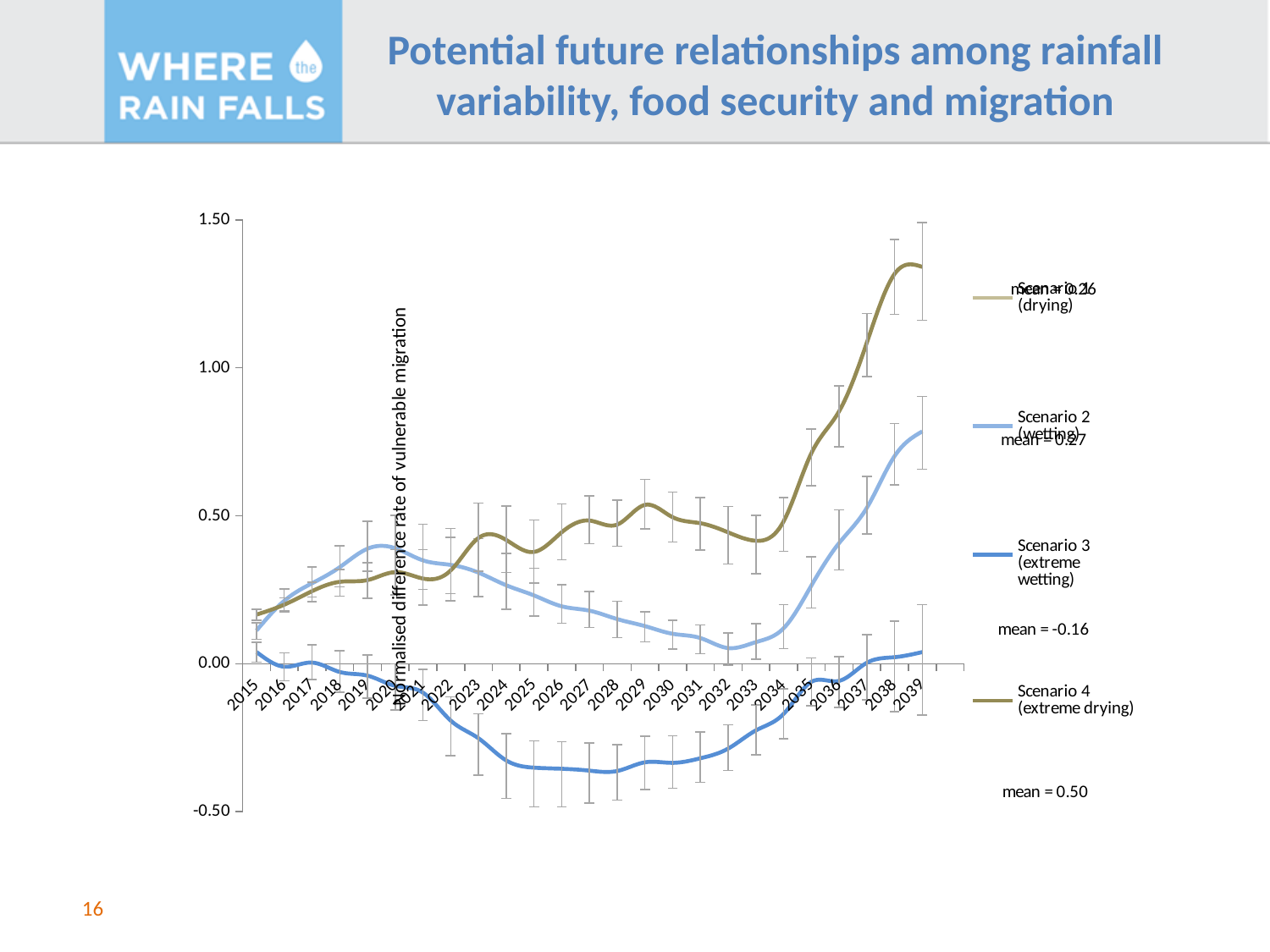
What type of chart is shown on the slide? line chart Does the Scenario 4 (extreme drying) line rise or fall between 2034 and 2039? rise How many scenarios does the legend list? 4 In 2039, which is higher: Scenario 4 (extreme drying) or Scenario 2 (wetting)? Scenario 4 (extreme drying) Is the value for Scenario 3 (extreme wetting) in 2028 greater or less than 0.00? less What is the label of the vertical axis? Normalised difference rate of vulnerable migration What mean value is shown for Scenario 3 (extreme wetting)? -0.16 Is the value for Scenario 4 (extreme drying) in 2039 greater or less than 1.00? greater How many years are plotted along the x axis? 25 What is the first year shown on the x axis? 2015 Is the value for Scenario 2 (wetting) in 2039 greater or less than 0.50? greater Does the Scenario 2 (wetting) line rise or fall between 2020 and 2032? fall